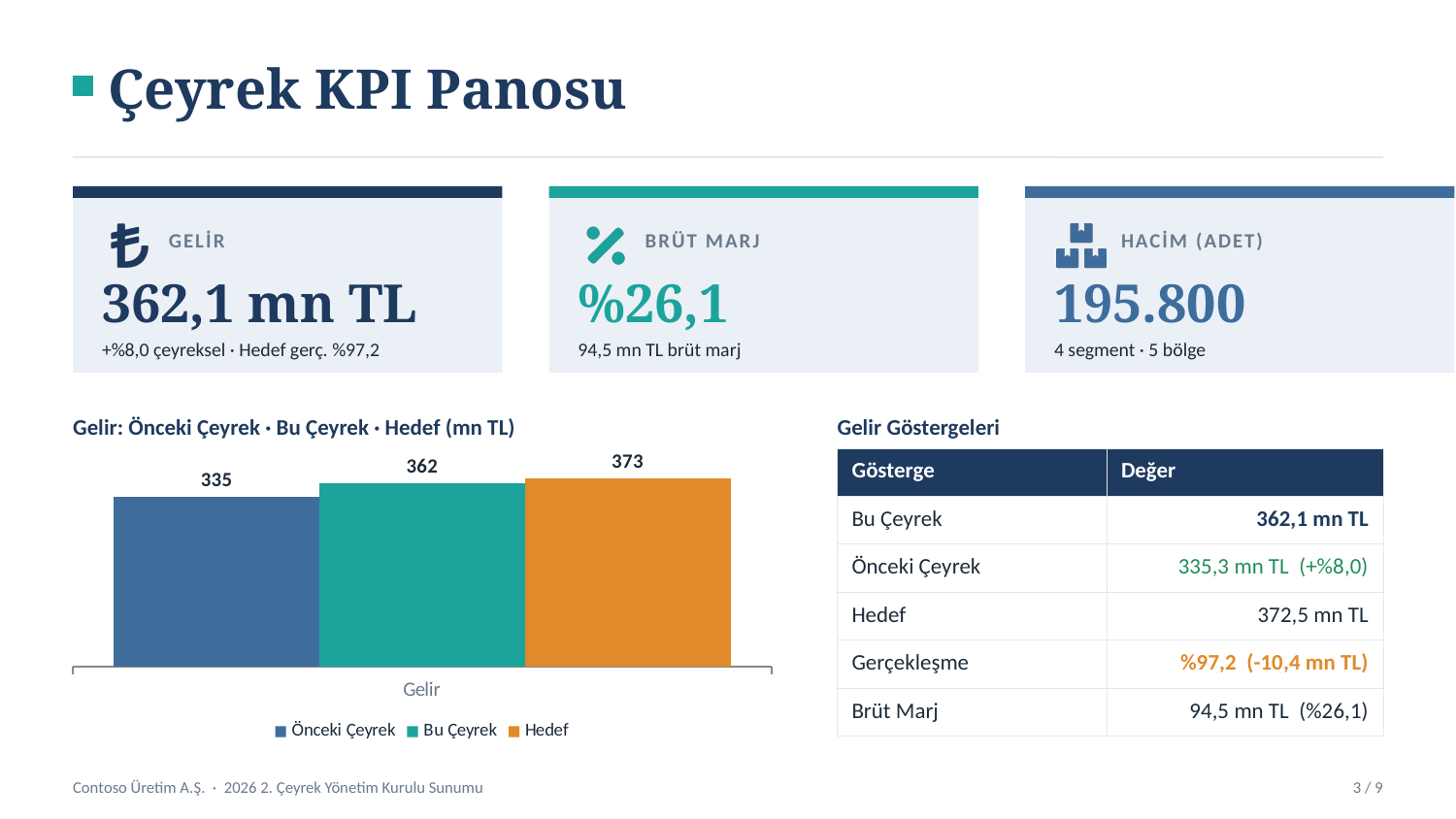
What is the value for Hedef in the chart? 373 How many series does the chart legend list? 3 What is the category label shown on the x axis of the chart? Gelir Which is larger in the chart, Bu Çeyrek or Önceki Çeyrek? Bu Çeyrek Which series has the highest value in the chart? Hedef What is the difference between the Bu Çeyrek and Önceki Çeyrek values in the chart? 27 What is the title of the chart? Gelir: Önceki Çeyrek · Bu Çeyrek · Hedef (mn TL) What is the value for Önceki Çeyrek in the chart? 335 What is the value for Bu Çeyrek in the chart? 362 What type of chart is shown on the slide? bar chart What is the difference between the Hedef and Bu Çeyrek values in the chart? 11 Which series has the lowest value in the chart? Önceki Çeyrek